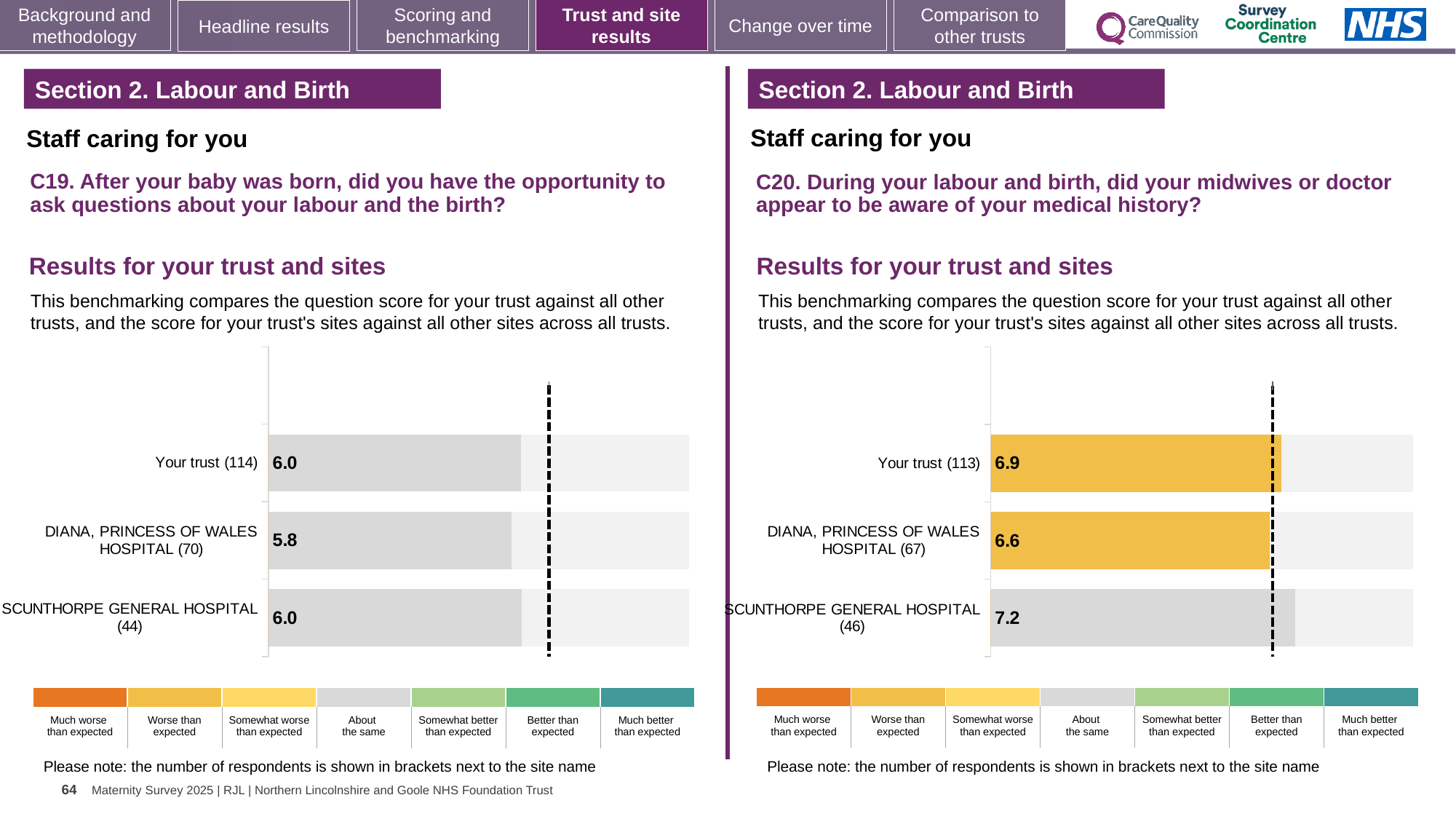
In the C19 chart on the left, what is the score for Your trust (114)? 6.0 In the C20 chart on the right, what is the score for SCUNTHORPE GENERAL HOSPITAL (46)? 7.2 In the C19 chart on the left, what is the score for DIANA, PRINCESS OF WALES HOSPITAL (70)? 5.8 In the C19 chart on the left, which site has the lowest score? DIANA, PRINCESS OF WALES HOSPITAL (70) In the C20 chart on the right, which site has the highest score? SCUNTHORPE GENERAL HOSPITAL (46) In the C20 chart on the right, which site has the lowest score? DIANA, PRINCESS OF WALES HOSPITAL (67) In the C20 chart on the right, what is the difference between the scores for SCUNTHORPE GENERAL HOSPITAL (46) and DIANA, PRINCESS OF WALES HOSPITAL (67)? 0.6 How many bars are shown in the C19 chart on the left? 3 In the C19 chart on the left, what is the difference between the score for Your trust (114) and DIANA, PRINCESS OF WALES HOSPITAL (70)? 0.2 In the C20 chart on the right, what is the score for Your trust (113)? 6.9 What type of chart is used in the C20 chart on the right? Bar chart In the C20 chart on the right, which has the larger score: Your trust (113) or DIANA, PRINCESS OF WALES HOSPITAL (67)? Your trust (113)